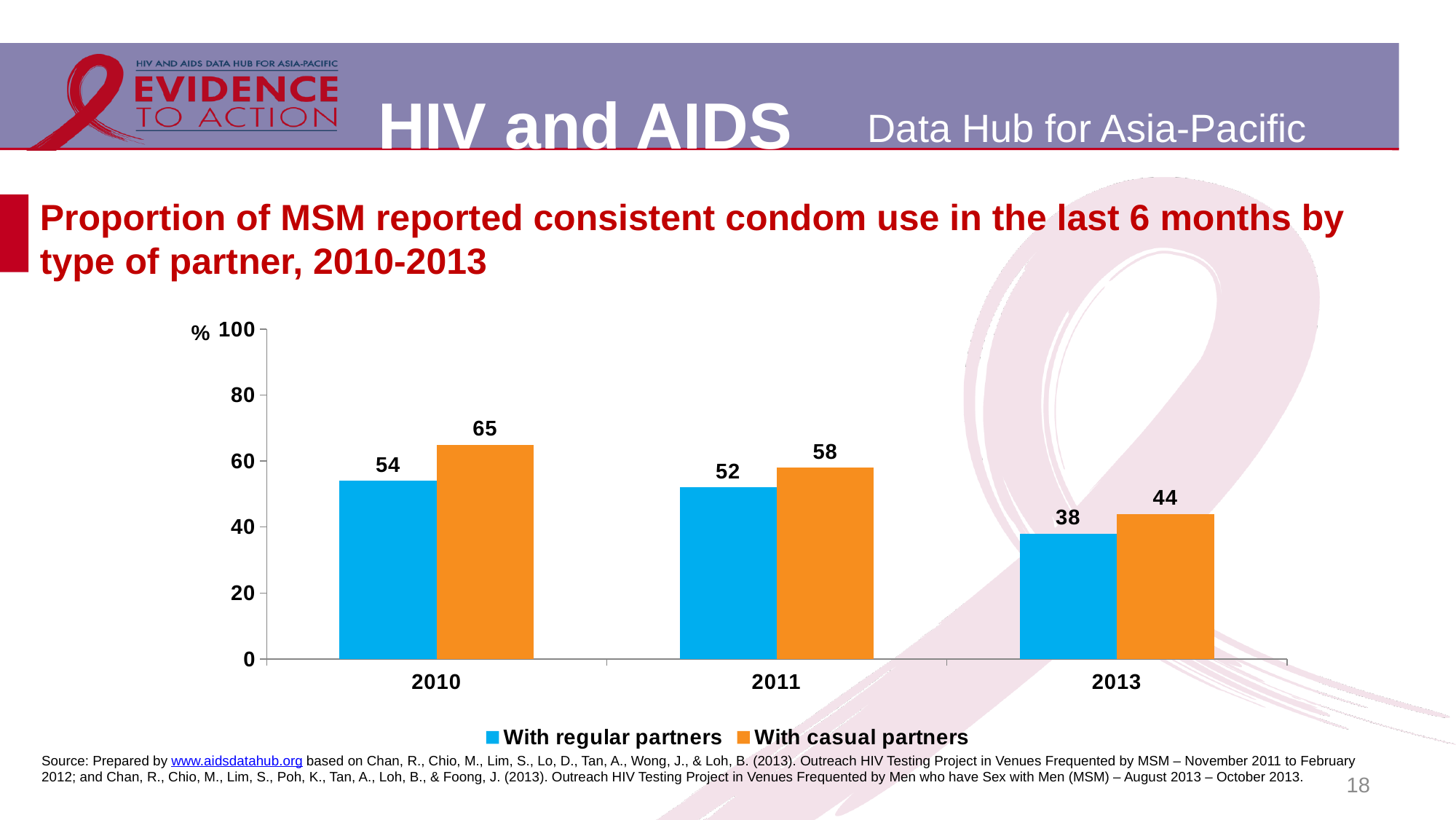
What is the value for 'With casual partners' in 2013? 44 What is the difference between 'With casual partners' and 'With regular partners' in 2010? 11 What is the value for 'With regular partners' in 2010? 54 What is the value for 'With casual partners' in 2011? 58 In which year is the value for 'With casual partners' highest? 2010 Is the value for 'With regular partners' in 2013 greater or less than 40? less In which year is the value for 'With regular partners' lowest? 2013 How many series does the legend list? 2 Which is larger in 2011: 'With regular partners' or 'With casual partners'? With casual partners Do the values for 'With regular partners' rise or fall from 2010 to 2013? Fall What kind of chart is shown on the slide? Bar chart How many years are shown on the x axis? 3